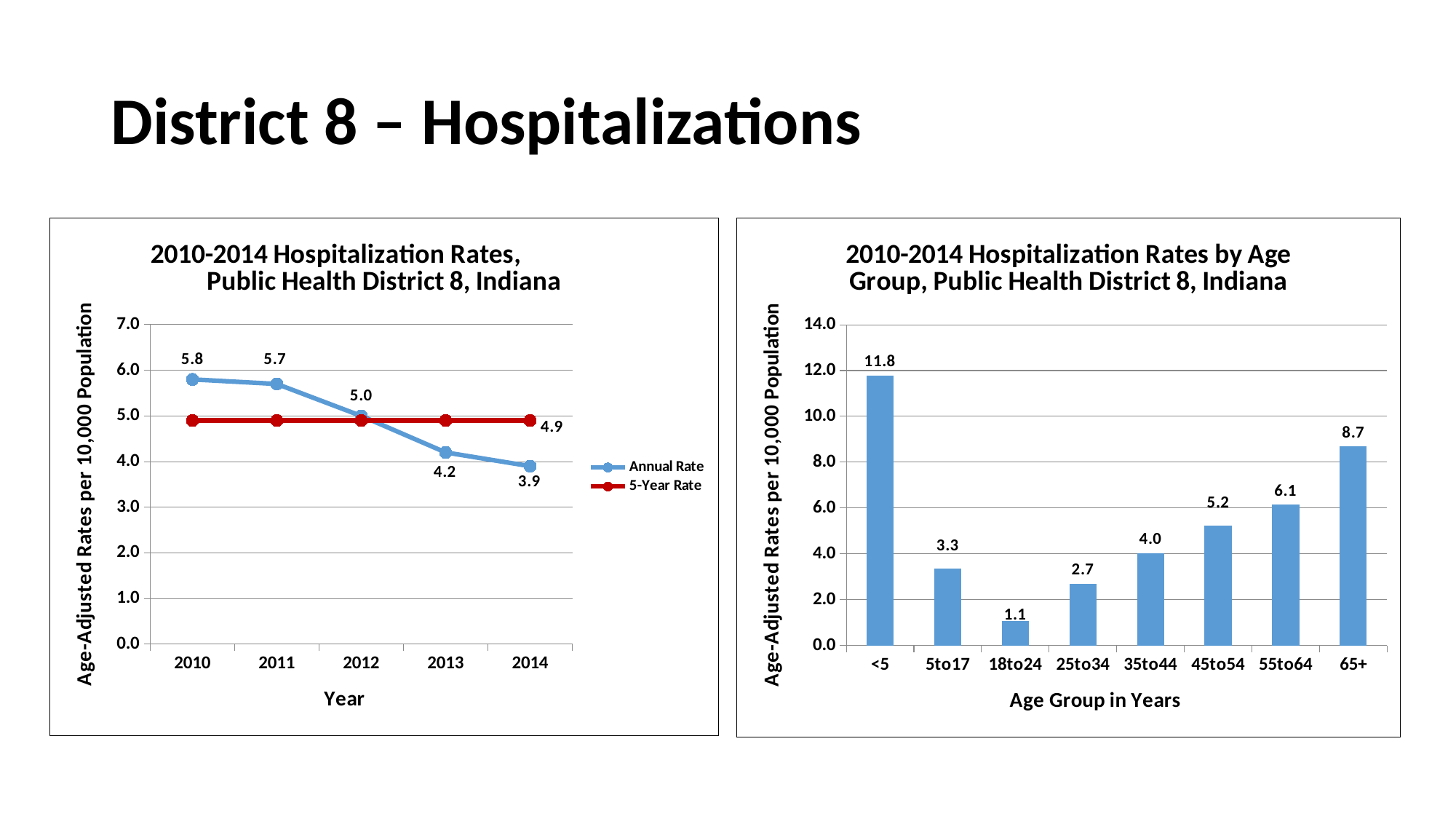
In the right chart (Hospitalization Rates by Age Group), which age group has the lowest rate? 18to24 In the right chart (Hospitalization Rates by Age Group), what is the difference between the rates for <5 and 65+? 3.1 In the left chart (2010-2014 Hospitalization Rates), which year has the lowest Annual Rate? 2014 In the right chart (Hospitalization Rates by Age Group), what is the rate for the 55to64 age group? 6.1 In the left chart (2010-2014 Hospitalization Rates), what type of chart is shown? line chart In the left chart (2010-2014 Hospitalization Rates), what is the 5-Year Rate? 4.9 In the left chart (2010-2014 Hospitalization Rates), how many series does the legend list? 2 In the right chart (Hospitalization Rates by Age Group), how many age groups are shown? 8 In the left chart (2010-2014 Hospitalization Rates), what is the Annual Rate for 2012? 5.0 In the left chart (2010-2014 Hospitalization Rates), does the Annual Rate rise or fall from 2010 to 2014? fall In the left chart (2010-2014 Hospitalization Rates), what is the difference between the Annual Rate in 2010 and in 2014? 1.9 In the right chart (Hospitalization Rates by Age Group), which age group has the highest rate? <5